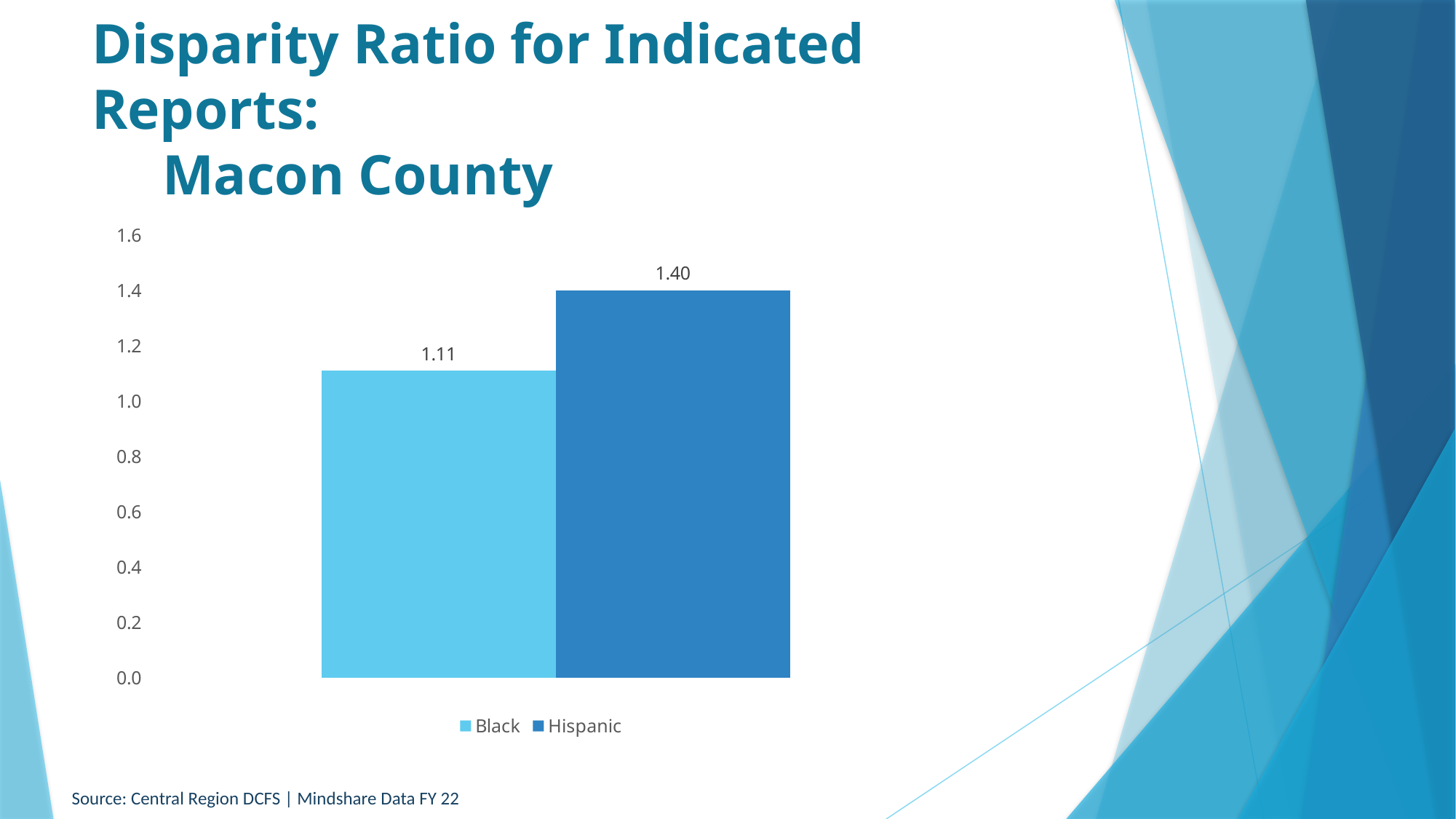
What kind of chart is shown on the slide? Bar chart What is the maximum value shown on the vertical axis? 1.6 What is the disparity ratio for Hispanic in the chart? 1.40 Is the disparity ratio for Black greater or less than 1.0? greater How many series does the legend list? 2 What is the disparity ratio for Black in the chart? 1.11 Which county does the chart title refer to? Macon County What is the difference between the Hispanic and Black disparity ratios? 0.29 Is the disparity ratio for Hispanic greater or less than 1.6? less Which group has the higher disparity ratio? Hispanic Which group has the lower disparity ratio? Black